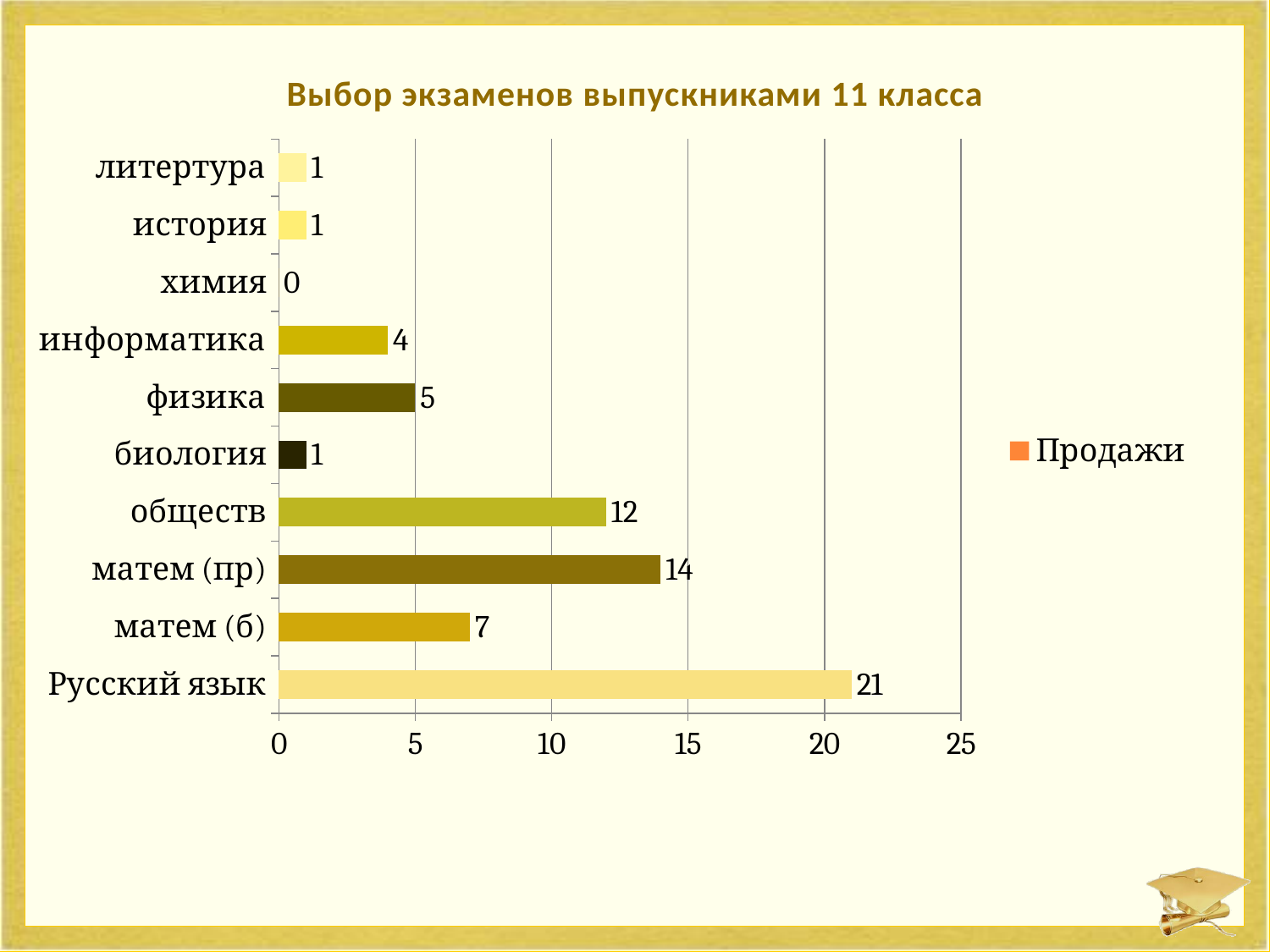
How many series does the legend list? 1 What is the value for информатика? 4 Which category has the highest value? Русский язык What is the value for матем (пр)? 14 Is the value for Русский язык greater or less than 20? greater What is the value for Русский язык? 21 What is the difference between the values for матем (пр) and матем (б)? 7 What is the title of the chart? Выбор экзаменов выпускниками 11 класса Which is larger, the value for обществ or the value for физика? обществ How many categories are shown on the chart? 10 What kind of chart is shown on the slide? bar chart Which category has the lowest value? химия